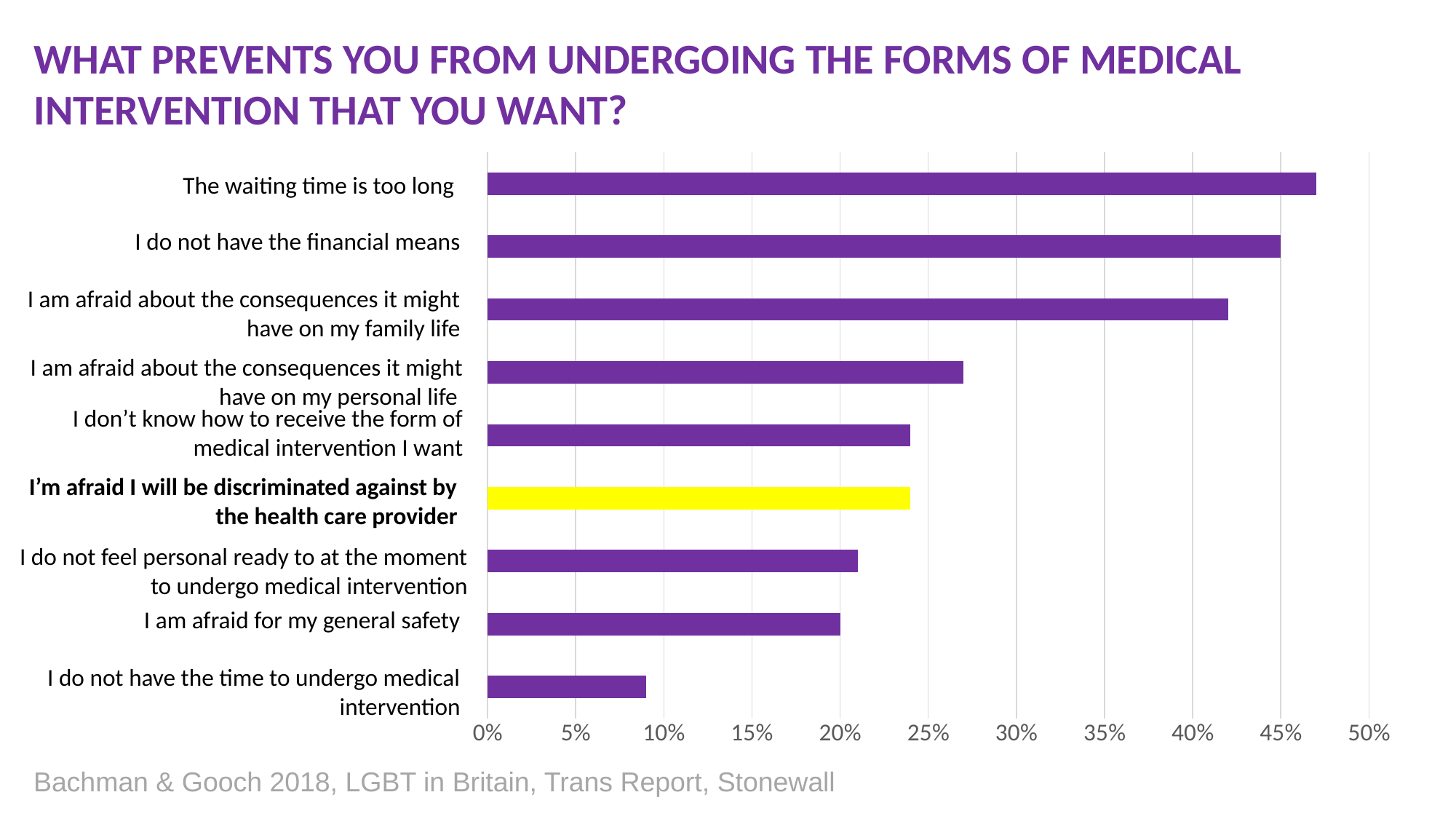
Is the value for "I'm afraid I will be discriminated against by the health care provider" greater or less than 20%? greater Which is larger: the value for fear of consequences on family life or the value for fear of consequences on personal life? fear of consequences on family life Is the value for "I do not have the time to undergo medical intervention" greater or less than 10%? less Is the value for "I am afraid about the consequences it might have on my personal life" greater or less than 25%? greater What kind of chart is shown on the slide? bar chart What is the title of the chart on the slide? What prevents you from undergoing the forms of medical intervention that you want? Which bar in the chart is highlighted in yellow? I'm afraid I will be discriminated against by the health care provider Which reason has the highest value in the chart? The waiting time is too long How many categories (reasons) are plotted in the chart? 9 Which reason has the lowest value in the chart? I do not have the time to undergo medical intervention